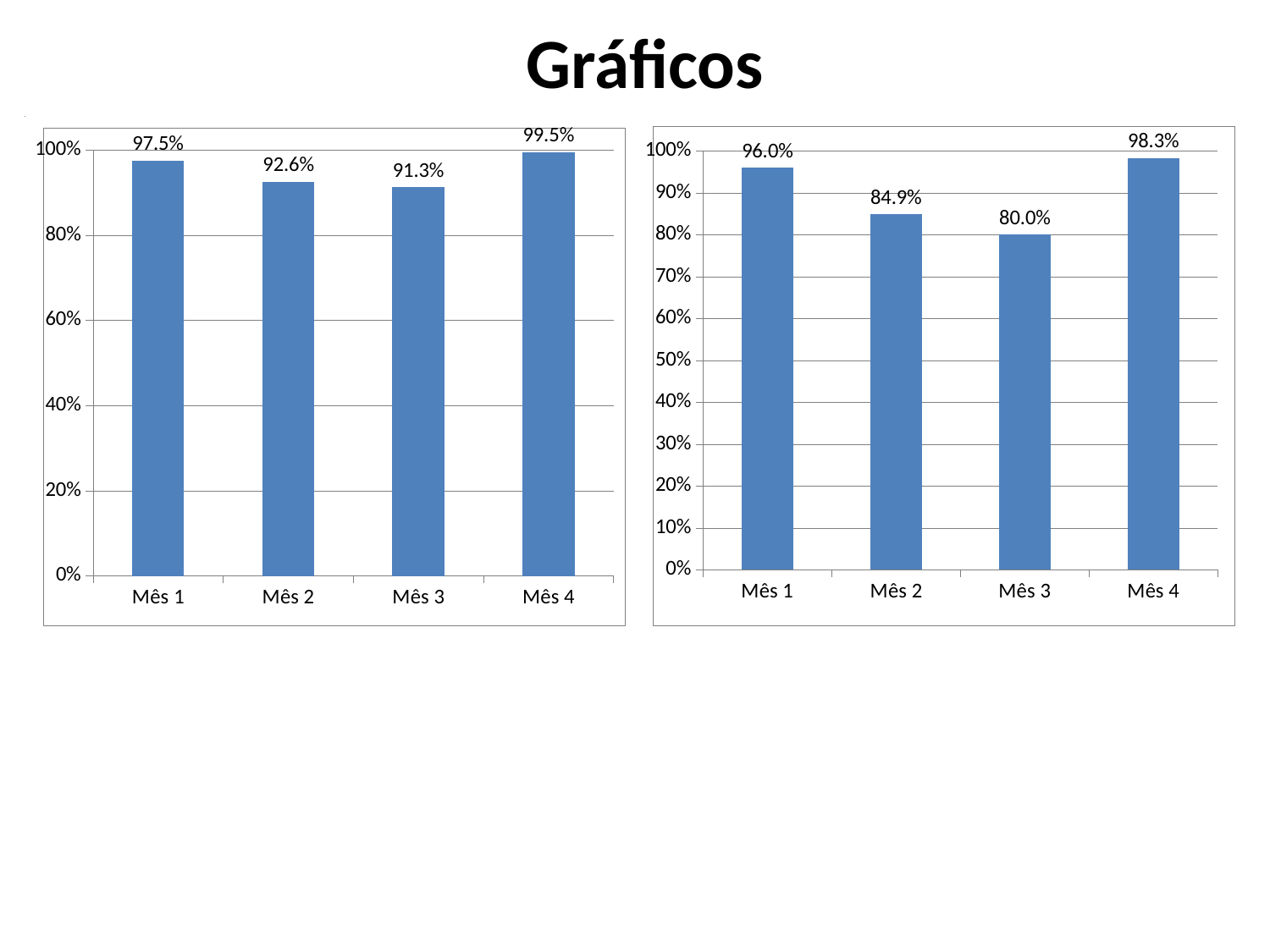
What is the title of the slide? Gráficos In the left chart, what is the value for Mês 3? 91.3% In the right chart, what is the difference between the values for Mês 1 and Mês 2? 11.1% In the right chart, which is larger, the value for Mês 1 or the value for Mês 4? Mês 4 In the right chart, what is the value for Mês 4? 98.3% In the left chart, what is the value for Mês 1? 97.5% In the left chart, what is the difference between the values for Mês 4 and Mês 3? 8.2% How many categories does the left chart show? 4 In the right chart, which month has the lowest value? Mês 3 In the right chart, what is the value for Mês 2? 84.9% In the left chart, which month has the highest value? Mês 4 What kind of chart is the right chart? Bar chart